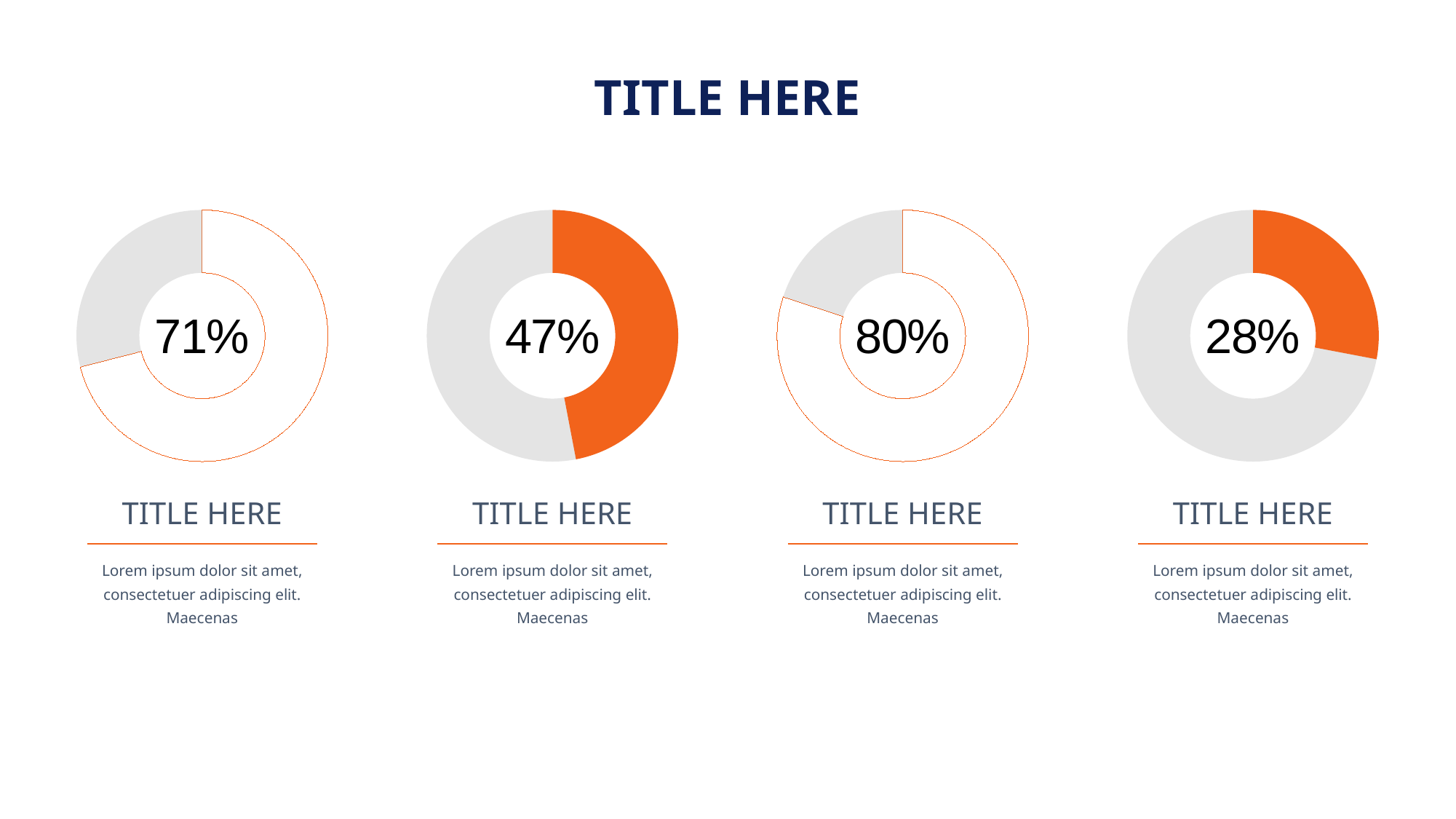
Which of the four donut charts shows the lowest percentage? The rightmost (28%) What percentage is shown in the centre of the leftmost donut chart? 71% What type of chart is used for each of the four figures on the slide? Donut chart How many donut charts are shown on the slide? 4 What percentage is shown in the centre of the rightmost donut chart? 28% What percentage is shown in the centre of the second donut chart from the left? 47% What colour is the filled segment in the second and fourth donut charts? Orange Which is larger: the percentage in the leftmost donut chart or the percentage in the second donut chart from the left? The leftmost (71%) What percentage is shown in the centre of the third donut chart from the left? 80% What is the difference between the percentage in the leftmost donut chart and the percentage in the second donut chart? 24% Which of the four donut charts shows the highest percentage? The third from the left (80%) What is the difference between the percentage in the third donut chart and the percentage in the rightmost donut chart? 52%